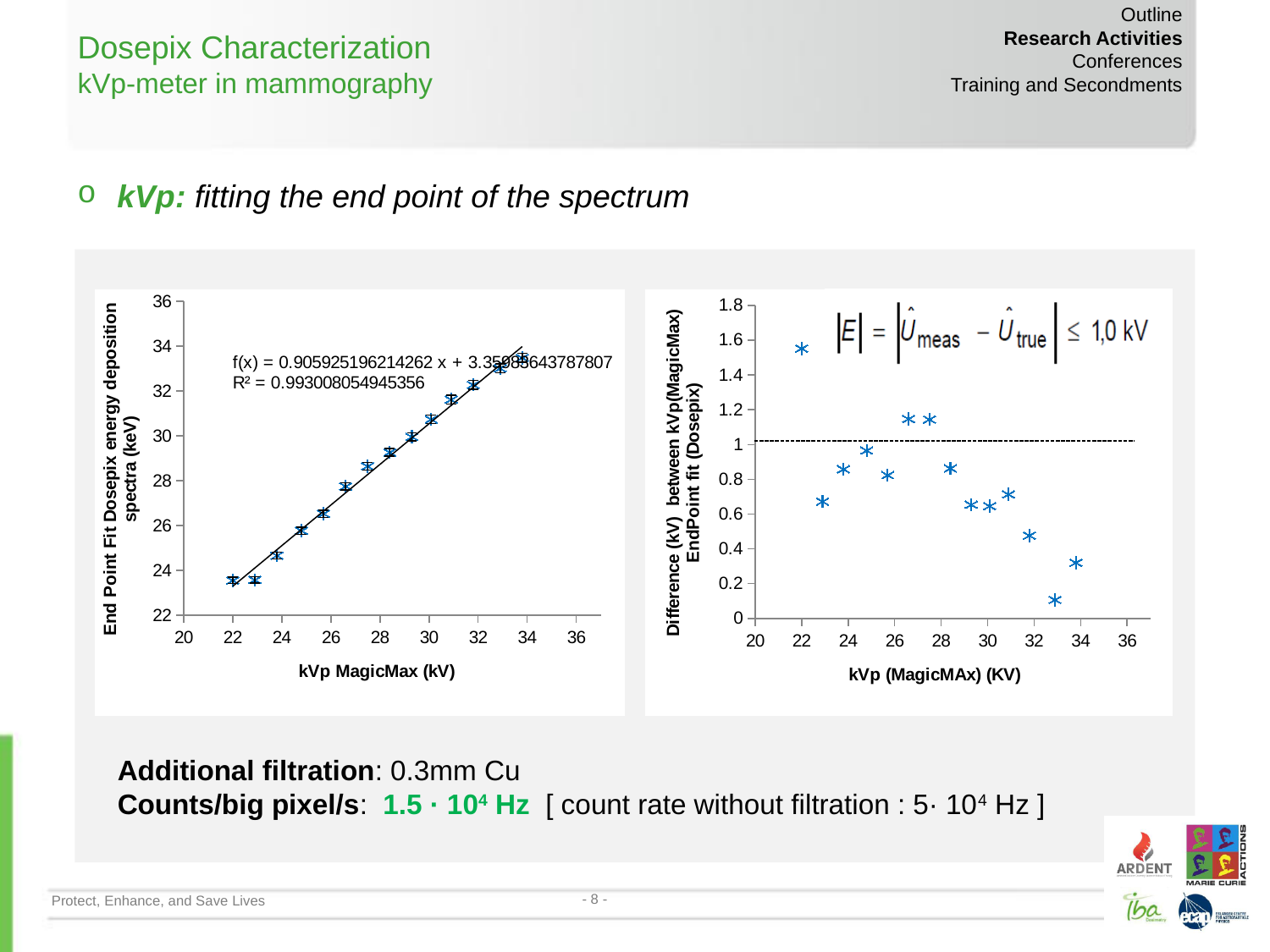
In the left chart, what is the fitted equation f(x) printed on the chart? f(x) = 0.905925196214262 x + 3.35988643787807 In the left chart, is the end point fit value at kVp MagicMax 34 kV greater or less than 32? greater In the right chart, is the difference at kVp 34 greater or less than 0.4? less In the right chart, which has the larger difference: the point at kVp 22 or the point at kVp 23? kVp 22 In the right chart, is the difference at kVp 33 greater or less than 0.2? less In the left chart, what R² value is printed for the linear fit? 0.993008054945356 In the left chart, do the end point fit values rise or fall as kVp MagicMax increases? rise In the right chart, at which kVp value is the difference lowest? 33 What kind of chart is the left chart (End Point Fit Dosepix energy deposition spectra vs kVp MagicMax)? scatter chart In the right chart (Difference between kVp(MagicMax) and EndPoint fit), at which kVp value is the difference highest? 22